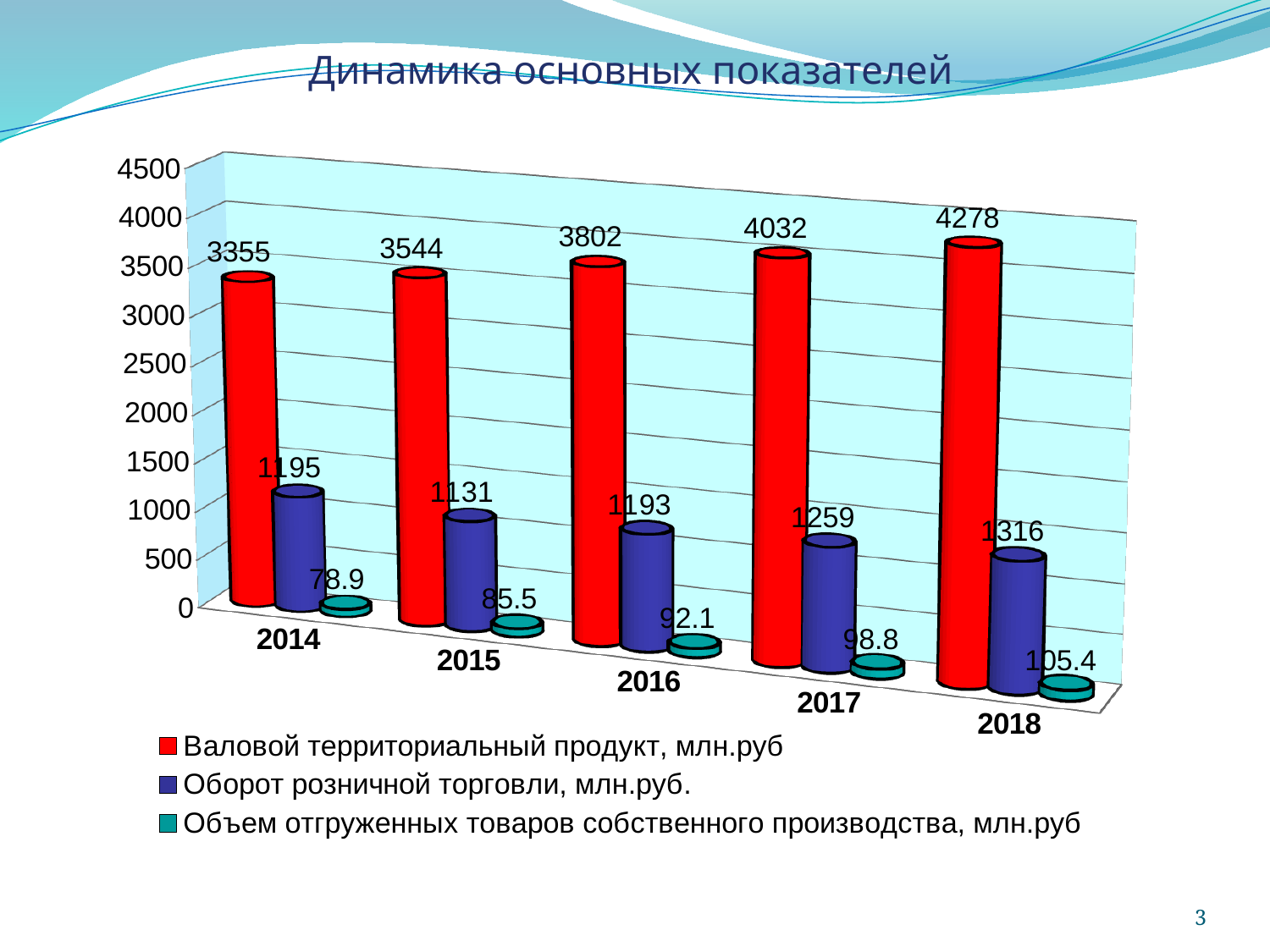
How many years are shown on the x axis? 5 What is the value of Объем отгруженных товаров собственного производства for 2016? 92.1 What is the value of Оборот розничной торговли for 2015? 1131 In which year is Оборот розничной торговли lowest? 2015 What is the difference between Валовой территориальный продукт in 2018 and in 2014? 923 Does Объем отгруженных товаров собственного производства rise or fall from 2014 to 2018? rise Which is larger: Оборот розничной торговли in 2014 or in 2016? 2014 How many series does the legend list? 3 What kind of chart is shown on the slide? bar chart In which year is Валовой территориальный продукт highest? 2018 What is the title of the chart? Динамика основных показателей What is the value of Валовой территориальный продукт for 2018? 4278